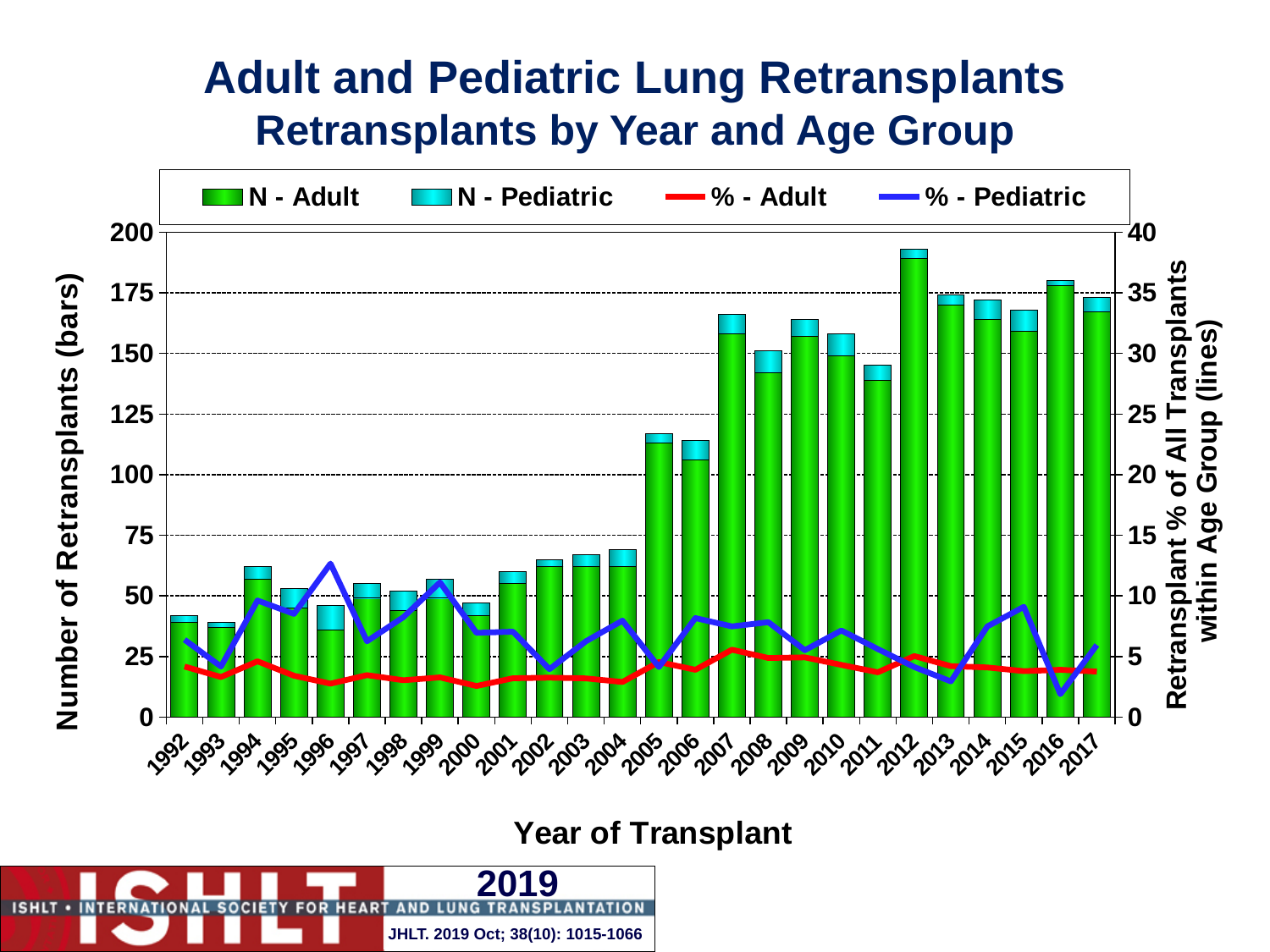
In 1996, which line is higher, % - Adult or % - Pediatric? % - Pediatric Which year has the taller total bar, 2011 or 2012? 2012 Is the % - Pediatric value in 2016 greater or less than 5? less Is the total number of retransplants in 1992 greater or less than 50? less Which year has the tallest bar for total number of retransplants? 2012 What is the label of the left vertical axis? Number of Retransplants (bars) How many years are shown along the x axis? 26 Which year has the shortest bar for total number of retransplants? 1993 Is the % - Pediatric value in 1996 greater or less than 10? greater What kind of chart is shown on the slide? A combination bar and line chart How many series does the legend list? 4